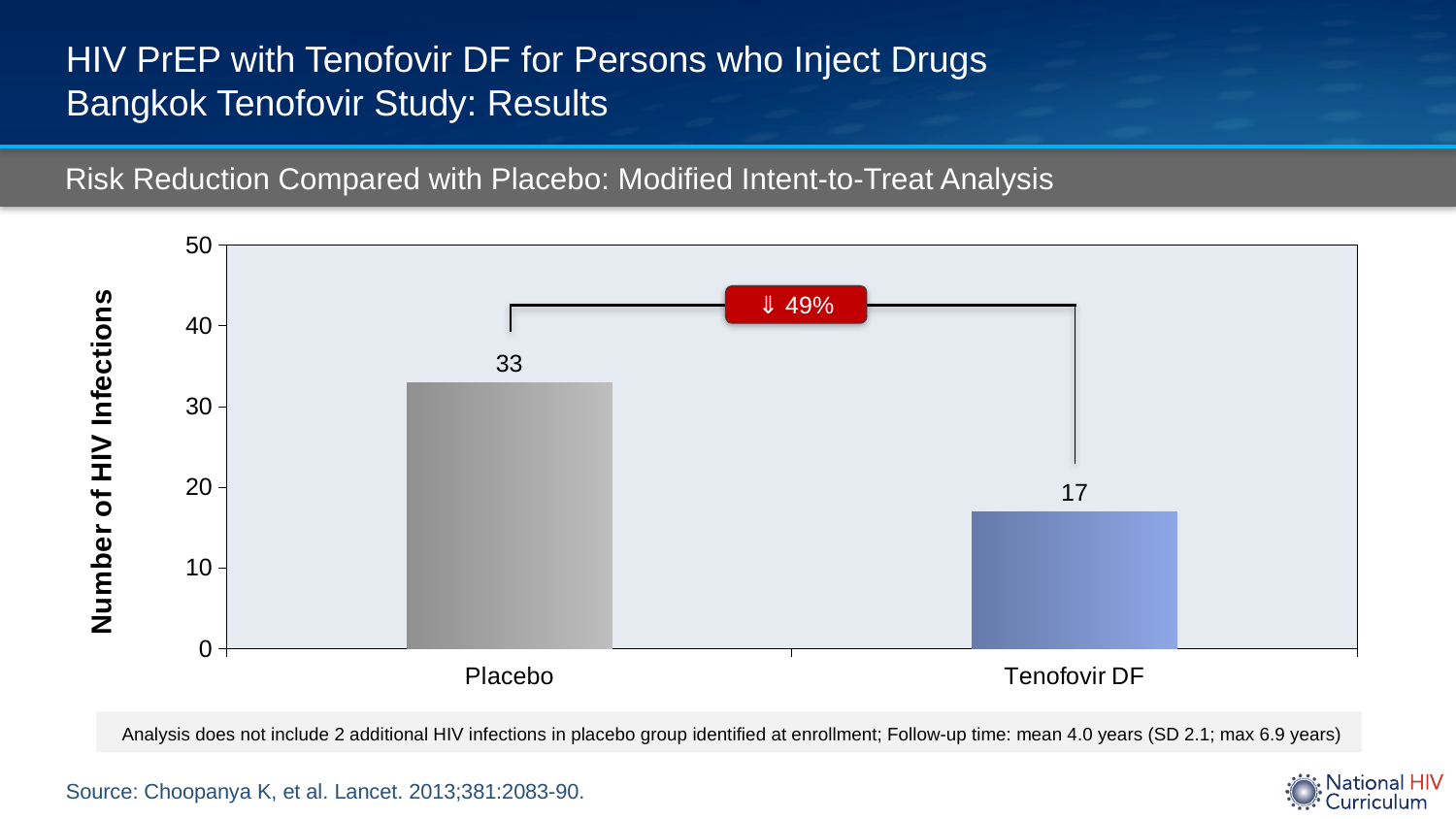
What is the label of the y axis of the chart? Number of HIV Infections What is the difference in the number of HIV infections between the Placebo and Tenofovir DF groups? 16 Is the value for Placebo greater or less than 30? greater How many groups are shown on the x axis of the chart? 2 What is the number of HIV infections for the Placebo group? 33 What kind of chart is shown on the slide? Bar chart Which group has the highest number of HIV infections? Placebo What percentage risk reduction is labeled on the chart? 49% Is the value for Tenofovir DF greater or less than 20? less Which group has the lowest number of HIV infections? Tenofovir DF What is the number of HIV infections for the Tenofovir DF group? 17 Which group has more HIV infections, Placebo or Tenofovir DF? Placebo